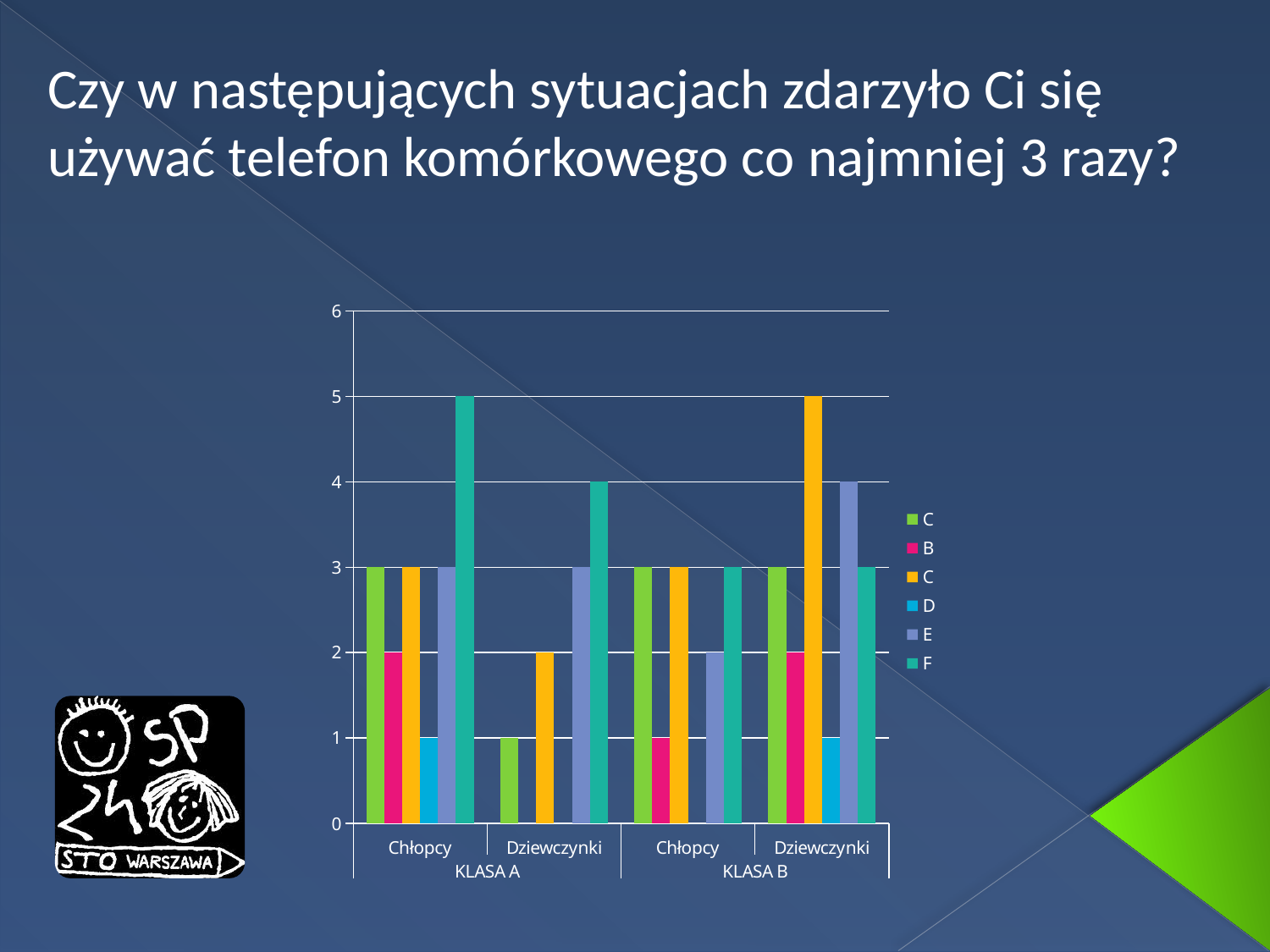
What is the value of series D for Chłopcy in KLASA A? 1 What is the value of series E for Dziewczynki in KLASA B? 4 How many categories are shown along the x axis? 4 What is the difference between the value of series F for Chłopcy in KLASA A and series F for Dziewczynki in KLASA A? 1 What is the value of series B for Chłopcy in KLASA B? 1 What kind of chart is shown on the slide? bar chart Is the value of series F for Chłopcy in KLASA A greater or less than 4? greater What is the highest value shown on the vertical axis? 6 Which series has the highest value for Chłopcy in KLASA A? F How many series does the legend list? 6 Which is larger: series E for Dziewczynki in KLASA B or series E for Chłopcy in KLASA B? Dziewczynki in KLASA B What is the value of series F for Chłopcy in KLASA A? 5